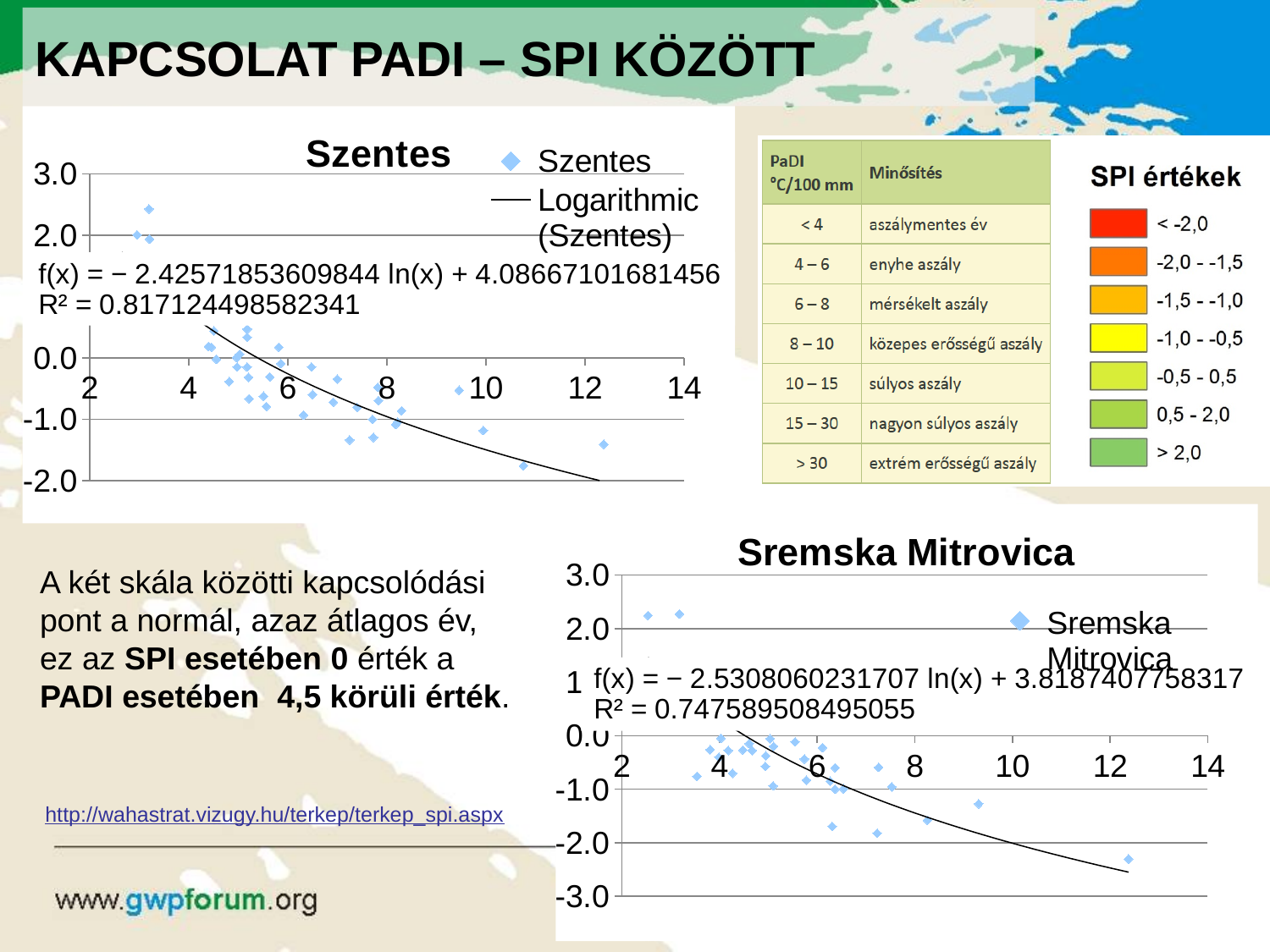
In the Sremska Mitrovica chart, is the value of the rightmost point (near x = 12) greater or less than -2.0? less In the Sremska Mitrovica chart, do the plotted values generally rise or fall as the x-axis value increases? fall In the Szentes chart, do the plotted values generally rise or fall as the x-axis value increases? fall In the Szentes chart, what is the R² value printed for the logarithmic trendline? R² = 0.817124498582341 What kind of chart is the Szentes chart? scatter chart What is the title of the chart in the lower right of the slide? Sremska Mitrovica Which chart has the higher R² value, Szentes or Sremska Mitrovica? Szentes In the Sremska Mitrovica chart, what is the R² value printed for the trendline? R² = 0.747589508495055 In the Szentes chart, is the value of the rightmost point (near x = 12) greater or less than -1.0? less In the Szentes chart, what is the trendline equation printed on the chart? f(x) = − 2.42571853609844 ln(x) + 4.08667101681456 How many entries does the legend of the Szentes chart list? 2 In the Sremska Mitrovica chart, what is the trendline equation printed on the chart? f(x) = − 2.5308060231707 ln(x) + 3.8187407758317